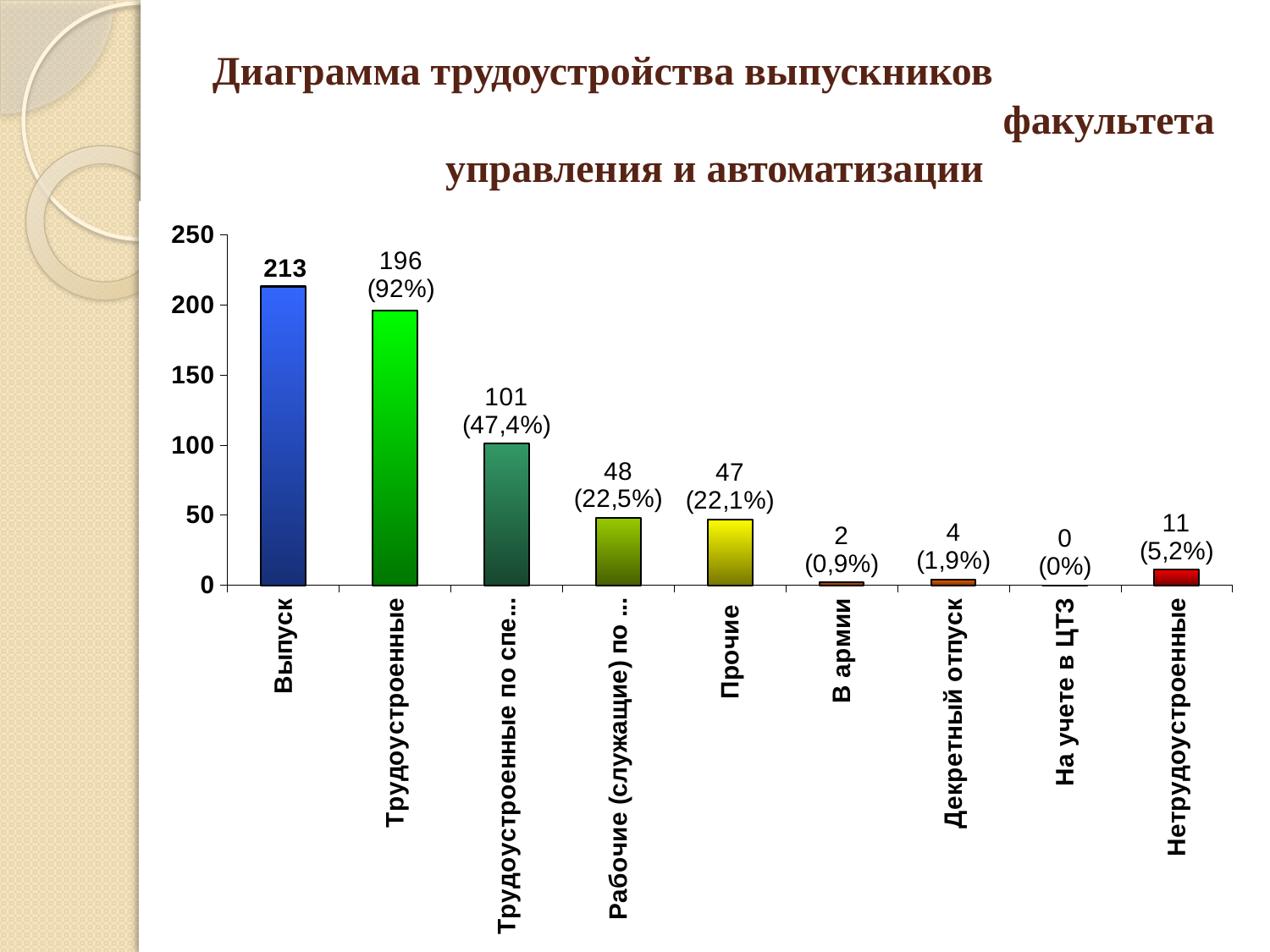
What is the value for Декретный отпуск? 4 How many categories are shown on the x axis? 9 What percentage is shown for Трудоустроенные? 92% Is the value for Прочие greater or less than 50? less What percentage is shown for Нетрудоустроенные? 5,2% What is the difference between the values for Выпуск and Трудоустроенные? 17 Which is larger, the value for В армии or the value for Декретный отпуск? Декретный отпуск What is the value for Выпуск? 213 What is the value for Трудоустроенные? 196 Which category has the lowest value? На учете в ЦТЗ What kind of chart is shown on the slide? bar chart Which category has the highest value? Выпуск